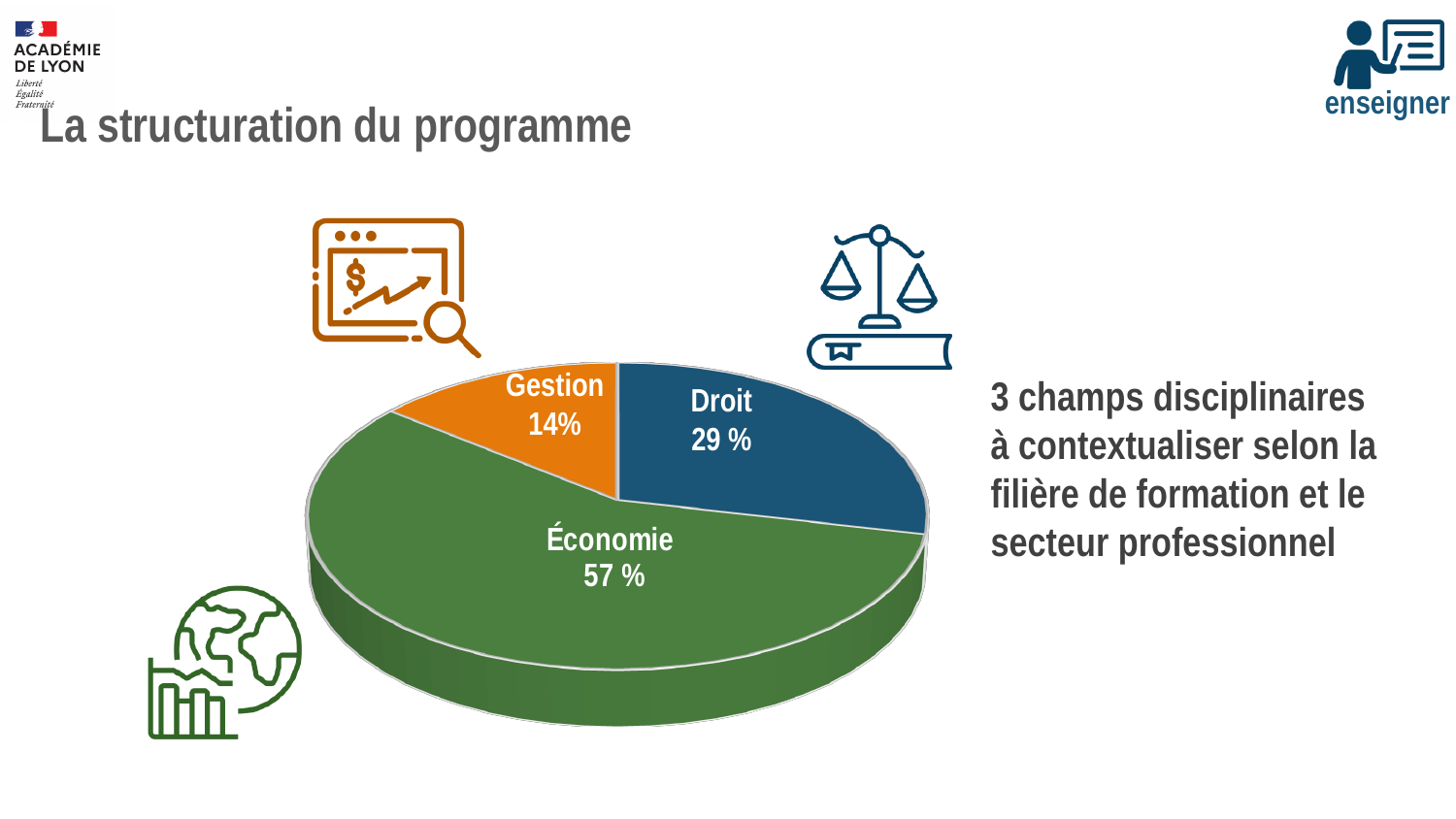
What share of the pie does Gestion represent? 14% What colour is the Droit slice of the pie chart? blue What colour is the Économie slice of the pie chart? green What is the difference in percentage points between the Économie slice and the Droit slice? 28 Which slice of the pie chart is the smallest? Gestion What kind of chart is shown on the slide? pie chart What is the difference in percentage points between the Droit slice and the Gestion slice? 15 How many slices does the pie chart have? 3 Which is larger, the Droit slice or the Gestion slice? Droit Which slice of the pie chart is the largest? Économie What share of the pie does Droit represent? 29 % What share of the pie does Économie represent? 57 %